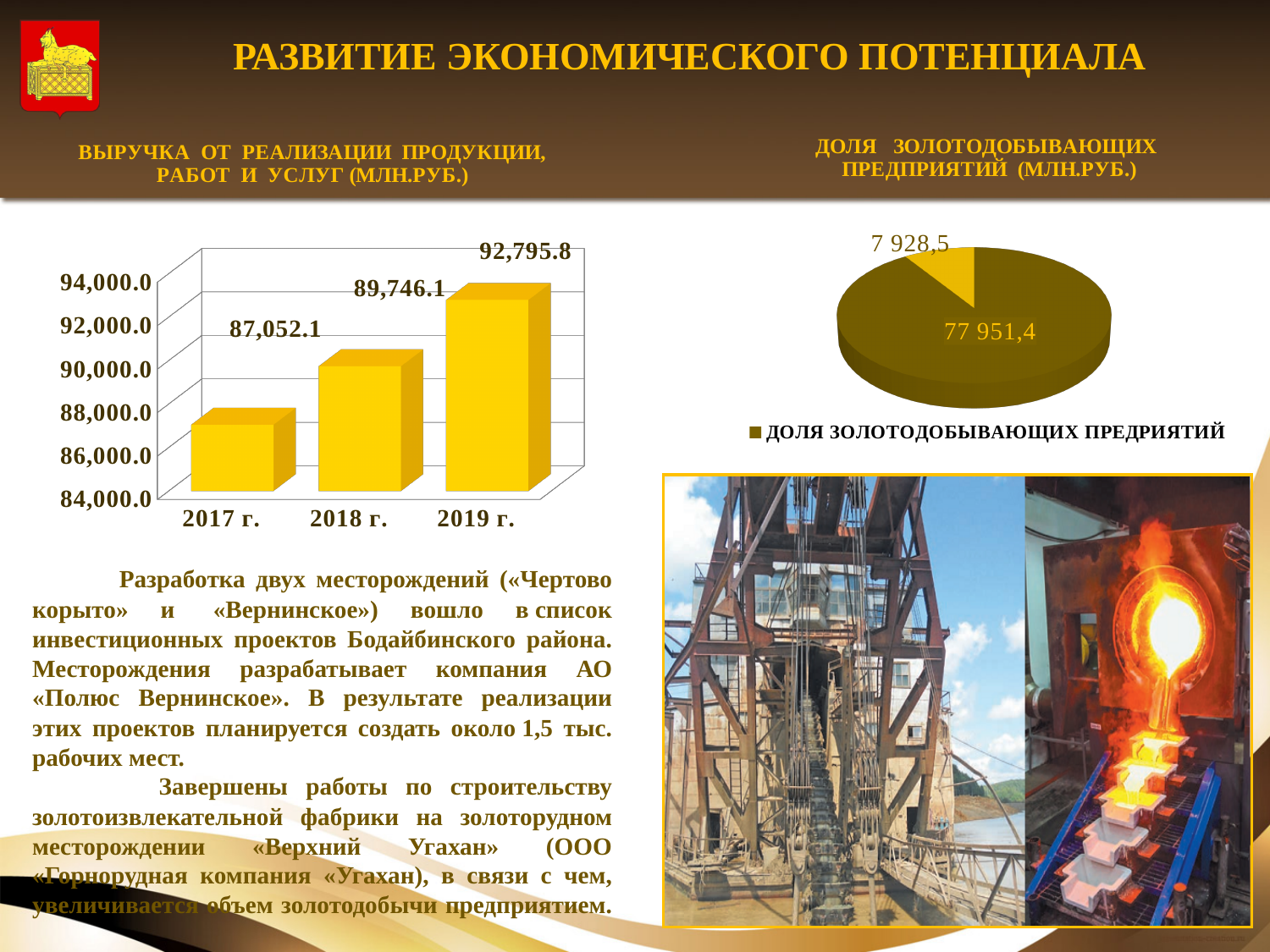
On the pie chart 'ДОЛЯ ЗОЛОТОДОБЫВАЮЩИХ ПРЕДПРИЯТИЙ (МЛН.РУБ.)', what is the value of the smaller slice? 7 928,5 What kind of chart is the right chart 'ДОЛЯ ЗОЛОТОДОБЫВАЮЩИХ ПРЕДПРИЯТИЙ (МЛН.РУБ.)'? pie chart On the pie chart 'ДОЛЯ ЗОЛОТОДОБЫВАЮЩИХ ПРЕДПРИЯТИЙ (МЛН.РУБ.)', what is the value of the larger slice? 77 951,4 On the bar chart 'ВЫРУЧКА ОТ РЕАЛИЗАЦИИ ПРОДУКЦИИ, РАБОТ И УСЛУГ (МЛН.РУБ.)', do the values rise or fall from 2017 г. to 2019 г.? rise On the bar chart 'ВЫРУЧКА ОТ РЕАЛИЗАЦИИ ПРОДУКЦИИ, РАБОТ И УСЛУГ (МЛН.РУБ.)', what is the value for 2018 г.? 89,746.1 On the bar chart 'ВЫРУЧКА ОТ РЕАЛИЗАЦИИ ПРОДУКЦИИ, РАБОТ И УСЛУГ (МЛН.РУБ.)', how many years are shown? 3 On the bar chart 'ВЫРУЧКА ОТ РЕАЛИЗАЦИИ ПРОДУКЦИИ, РАБОТ И УСЛУГ (МЛН.РУБ.)', what is the value for 2017 г.? 87,052.1 On the bar chart 'ВЫРУЧКА ОТ РЕАЛИЗАЦИИ ПРОДУКЦИИ, РАБОТ И УСЛУГ (МЛН.РУБ.)', which year has the lowest value? 2017 г. On the bar chart 'ВЫРУЧКА ОТ РЕАЛИЗАЦИИ ПРОДУКЦИИ, РАБОТ И УСЛУГ (МЛН.РУБ.)', which year has the highest value? 2019 г. On the bar chart 'ВЫРУЧКА ОТ РЕАЛИЗАЦИИ ПРОДУКЦИИ, РАБОТ И УСЛУГ (МЛН.РУБ.)', what is the difference between the 2019 г. and 2018 г. values? 3,049.7 On the bar chart 'ВЫРУЧКА ОТ РЕАЛИЗАЦИИ ПРОДУКЦИИ, РАБОТ И УСЛУГ (МЛН.РУБ.)', what is the difference between the 2019 г. and 2017 г. values? 5,743.7 What kind of chart is the left chart 'ВЫРУЧКА ОТ РЕАЛИЗАЦИИ ПРОДУКЦИИ, РАБОТ И УСЛУГ (МЛН.РУБ.)'? bar chart